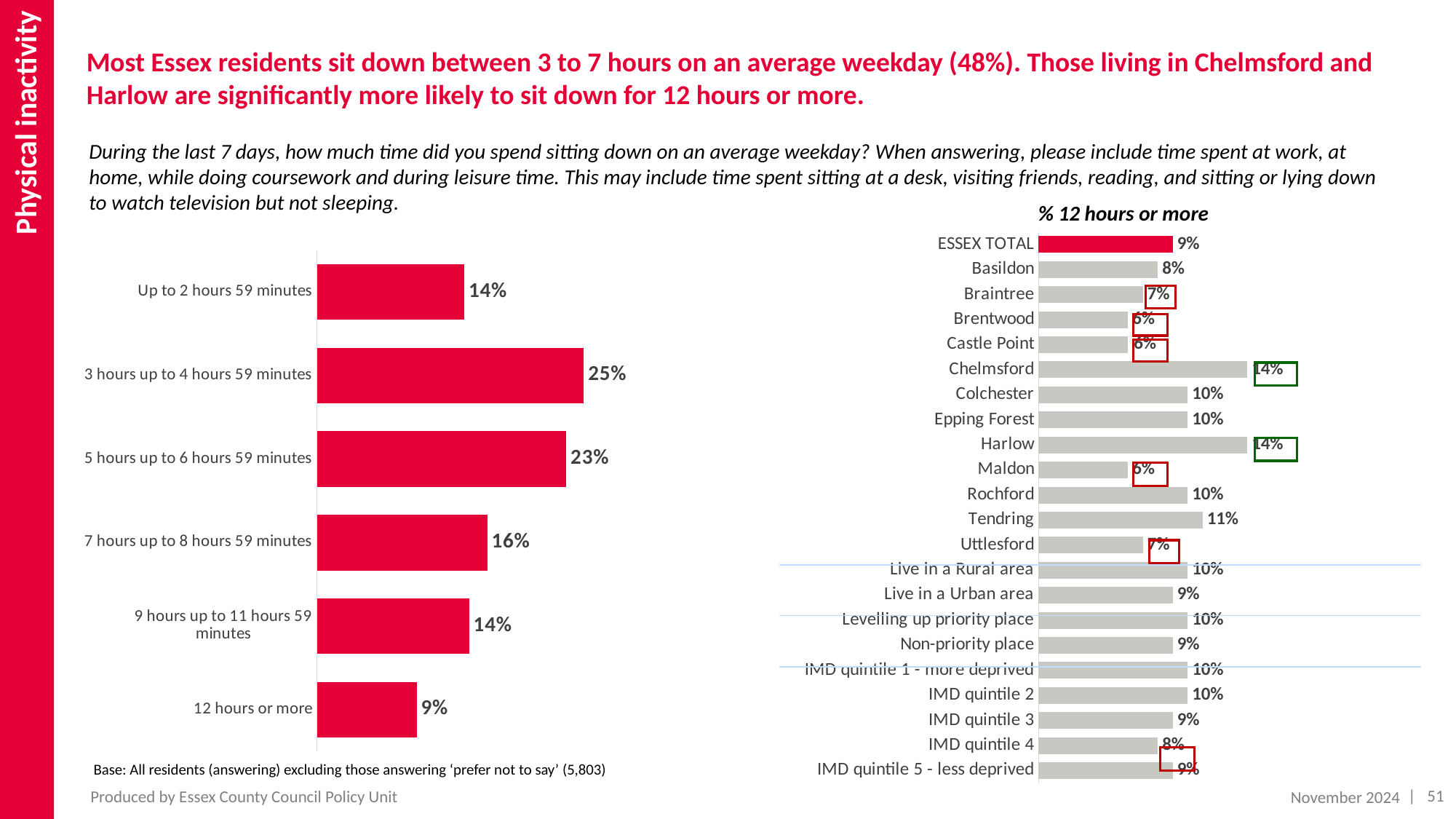
In the left chart, which category has the highest percentage? 3 hours up to 4 hours 59 minutes In the '% 12 hours or more' chart, what is the value for Tendring? 11% In the left chart, which category has the lowest percentage? 12 hours or more In the left chart, what is the difference between the percentages for 5 hours up to 6 hours 59 minutes and 7 hours up to 8 hours 59 minutes? 7% In the left chart, what percentage of residents sit down for 12 hours or more? 9% In the '% 12 hours or more' chart, what is the value for Chelmsford? 14% In the '% 12 hours or more' chart, which is larger, Basildon or Colchester? Colchester In the '% 12 hours or more' chart, what is the difference between Harlow and ESSEX TOTAL? 5% What type of chart is the left chart? Bar chart In the left chart, what percentage of residents sit down for 3 hours up to 4 hours 59 minutes? 25% What is the title of the right-hand chart? % 12 hours or more How many categories are shown in the left chart? 6